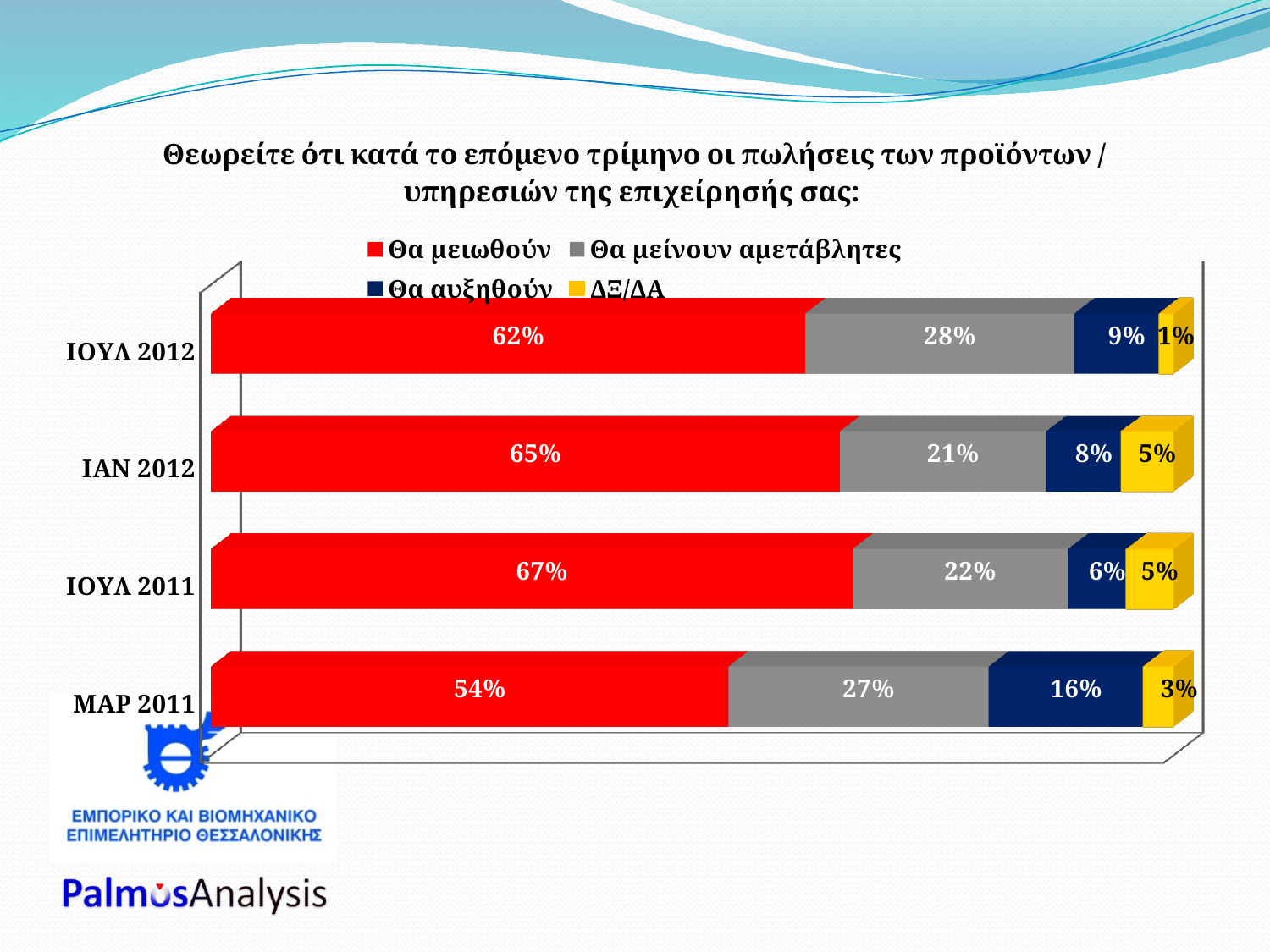
What kind of chart is shown on the slide? Stacked bar chart Which is larger: the "Θα μείνουν αμετάβλητες" value for ΙΟΥΛ 2012 or for ΙΟΥΛ 2011? ΙΟΥΛ 2012 What percentage of respondents in ΙΟΥΛ 2012 answered "Θα μειωθούν"? 62% What is the total of the stacked bar for ΙΑΝ 2012? 99% What is the value for "ΔΞ/ΔΑ" in ΙΟΥΛ 2011? 5% In which period is the "Θα αυξηθούν" share the lowest? ΙΟΥΛ 2011 What is the difference between the "Θα μειωθούν" values for ΙΟΥΛ 2011 and ΜΑΡ 2011? 13 percentage points What is the value for "Θα μείνουν αμετάβλητες" in ΙΑΝ 2012? 21% In which period is the "Θα μειωθούν" share the highest? ΙΟΥΛ 2011 How many periods (categories) are shown on the chart? 4 What is the value for "Θα αυξηθούν" in ΜΑΡ 2011? 16% How many series does the legend list? 4